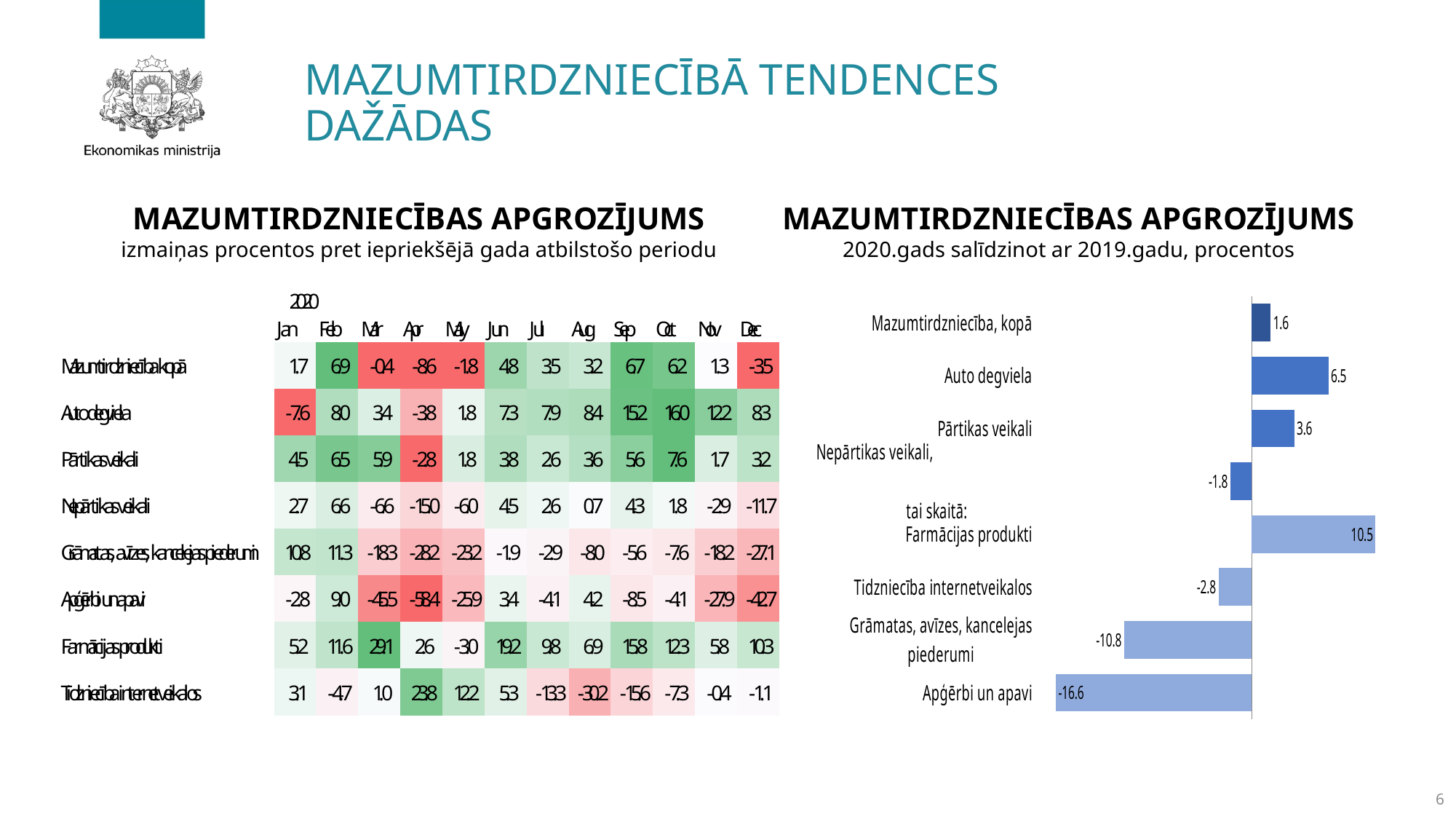
What kind of chart is shown on the right-hand side of the slide? Bar chart What is the subtitle of the right-hand chart? 2020.gads salīdzinot ar 2019.gadu, procentos In the right-hand bar chart (2020 compared with 2019), what is the value for Mazumtirdzniecība, kopā? 1.6 In the right-hand bar chart (2020 compared with 2019), what is the value for Auto degviela? 6.5 In the right-hand bar chart (2020 compared with 2019), which category has the highest value? Farmācijas produkti In the right-hand bar chart (2020 compared with 2019), what is the value for Tidzniecība internetveikalos? -2.8 In the right-hand bar chart (2020 compared with 2019), which category has the lowest value? Apģērbi un apavi In the right-hand bar chart (2020 compared with 2019), which is larger: the value for Pārtikas veikali or the value for Mazumtirdzniecība, kopā? Pārtikas veikali In the left-hand heatmap table, how many months are shown as columns? 12 In the right-hand bar chart (2020 compared with 2019), what is the difference between the values for Auto degviela and Pārtikas veikali? 2.9 In the right-hand bar chart (2020 compared with 2019), how many categories are plotted? 8 In the right-hand bar chart (2020 compared with 2019), how many categories have negative values? 4